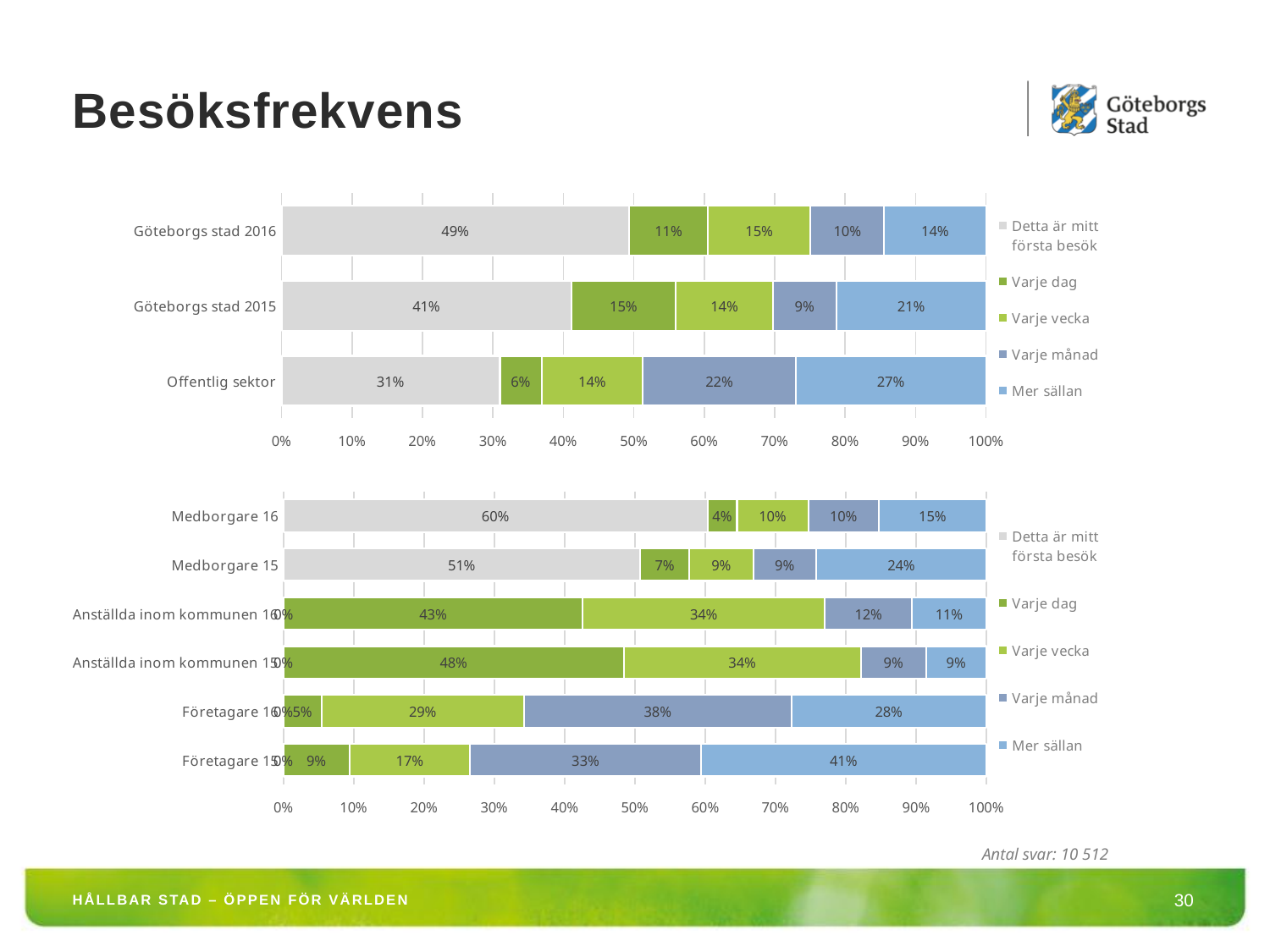
In the bottom chart, what is the value of "Varje dag" for Anställda inom kommunen 15? 48% What type of chart is the bottom chart? Stacked bar chart In the top chart, what is the value of "Mer sällan" for Offentlig sektor? 27% In the top chart, what is the value of "Detta är mitt första besök" for Göteborgs stad 2016? 49% In the bottom chart, which category has the highest value for "Detta är mitt första besök"? Medborgare 16 In the bottom chart, how many categories are shown? 6 In the top chart, what is the difference between the "Mer sällan" values for Göteborgs stad 2015 and Göteborgs stad 2016? 7% In the top chart, which category has the highest value for "Varje månad"? Offentlig sektor In the bottom chart, what is the value of "Mer sällan" for Företagare 15? 41% How many series does the legend of the top chart list? 5 In the top chart, how many categories are shown? 3 In the bottom chart, which is larger: the "Varje månad" value for Företagare 16 or for Företagare 15? Företagare 16